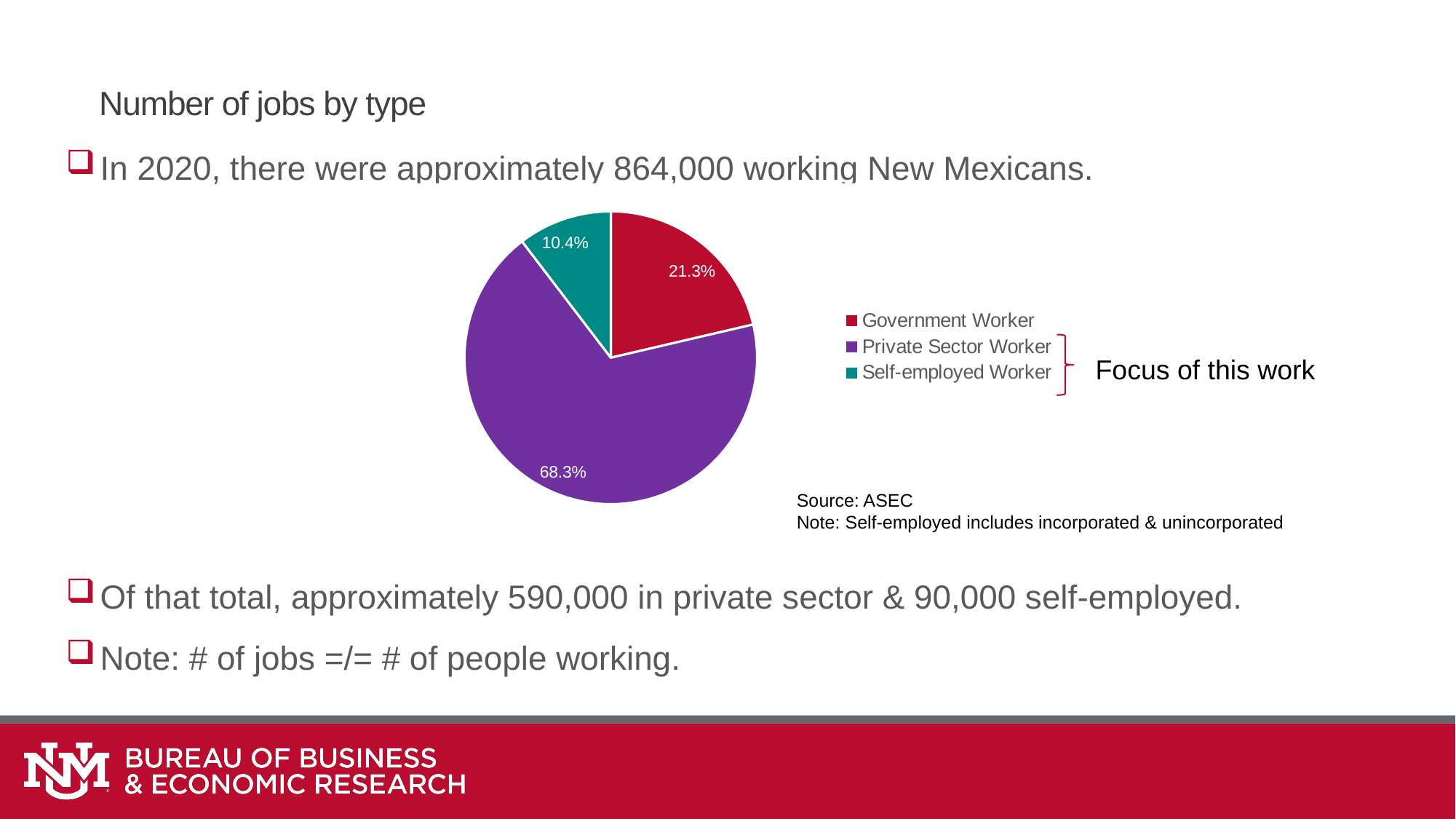
What is the difference in percentage points between the Private Sector Worker and Government Worker slices? 47.0 percentage points What is the difference in percentage points between the Government Worker and Self-employed Worker slices? 10.9 percentage points What colour is the Private Sector Worker slice? Purple Which category has the largest slice of the pie? Private Sector Worker Which category has the smallest slice of the pie? Self-employed Worker Which is larger, the Government Worker slice or the Self-employed Worker slice? Government Worker How many categories does the pie chart show? 3 What share of the pie is Government Worker? 21.3% What share of the pie is Private Sector Worker? 68.3% What share of the pie is Self-employed Worker? 10.4% What type of chart is shown on the slide? Pie chart Which two legend categories are bracketed as the 'Focus of this work'? Private Sector Worker and Self-employed Worker